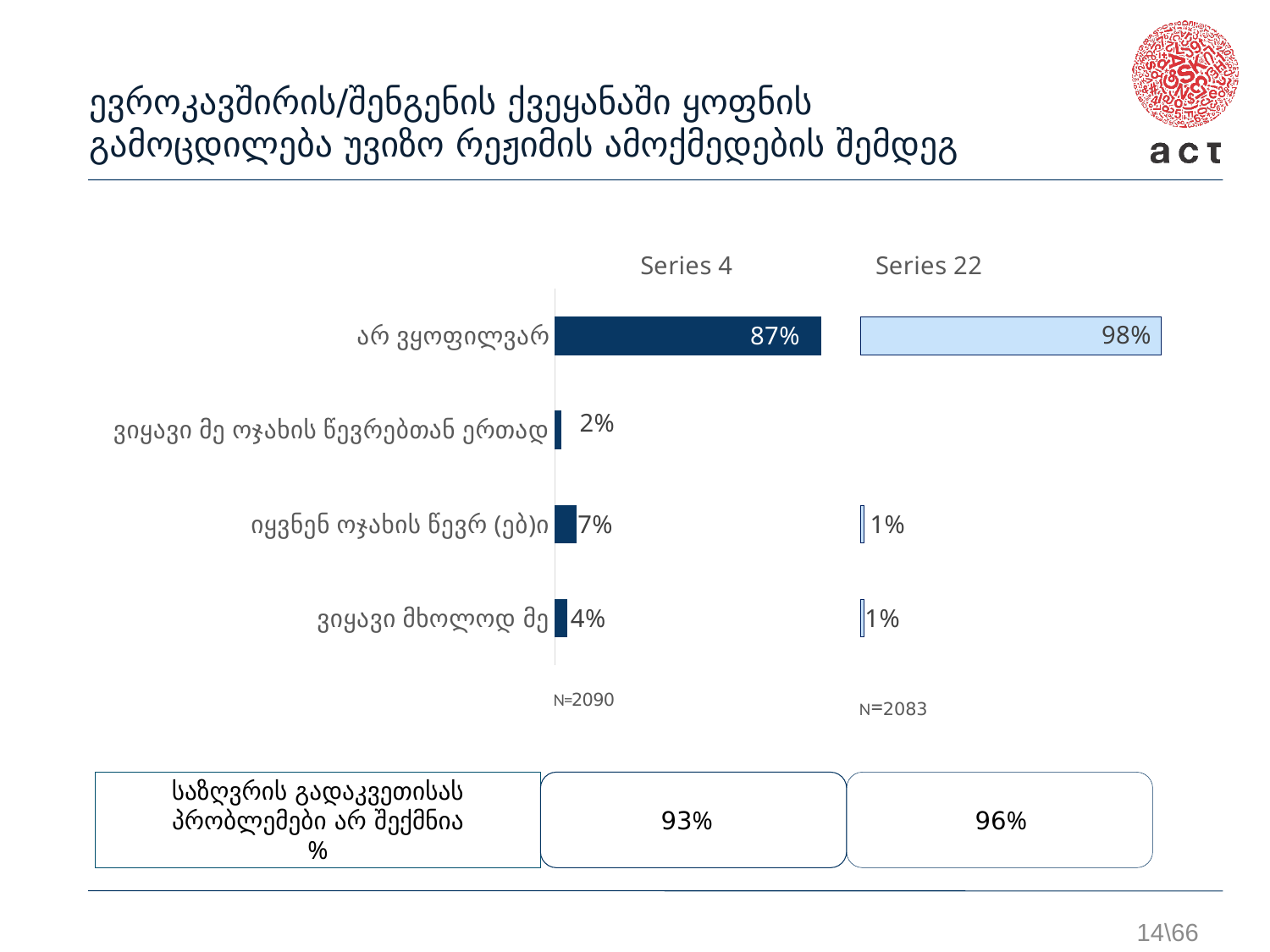
How many series does the chart show? 2 How many categories are shown on the chart? 4 What kind of chart is shown on the slide? Bar chart Which is larger for "იყვნენ ოჯახის წევრ(ებ)ი": the Series 4 value or the Series 22 value? Series 4 What is the value for "არ ვყოფილვარ" in Series 4? 87% What is the value for "ვიყავი მე ოჯახის წევრებთან ერთად" in Series 4? 2% Which category has the lowest value in Series 4? ვიყავი მე ოჯახის წევრებთან ერთად What is the value for "იყვნენ ოჯახის წევრ(ებ)ი" in Series 4? 7% What is the difference between the Series 22 and Series 4 values for "არ ვყოფილვარ"? 11% Which category has the highest value in Series 4? არ ვყოფილვარ What is the value for "არ ვყოფილვარ" in Series 22? 98% What is the value for "ვიყავი მხოლოდ მე" in Series 22? 1%